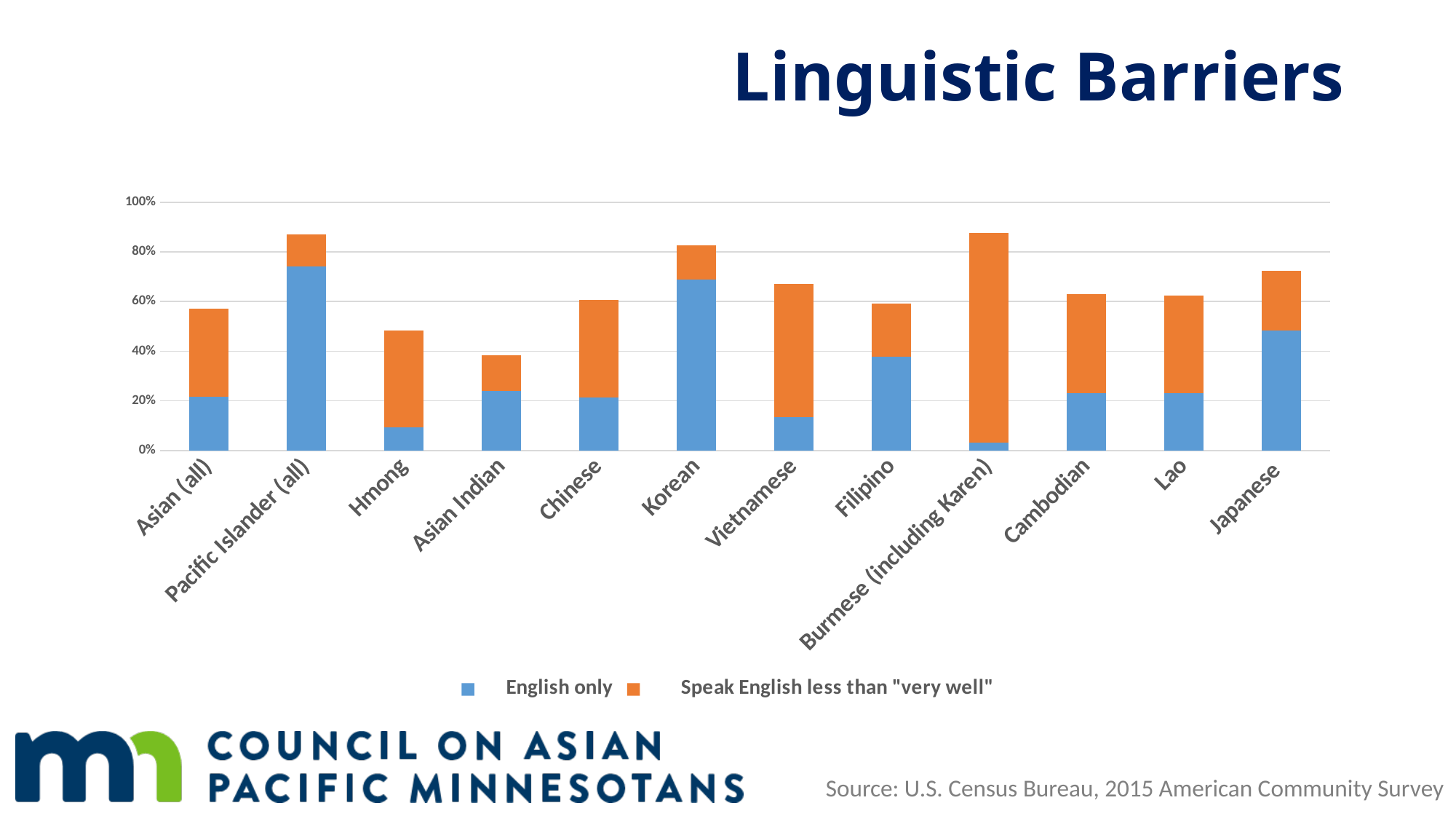
Is the 'English only' value for Japanese greater or less than 40%? greater Is the 'English only' value for Hmong greater or less than 20%? less How many series does the legend list? 2 How many population groups are shown along the x axis? 12 Which group has the largest 'Speak English less than "very well"' segment? Burmese (including Karen) Which group has the lowest 'English only' value? Burmese (including Karen) Which group has the highest 'English only' value? Pacific Islander (all) Is the 'English only' value for Pacific Islander (all) greater or less than 60%? greater Which has the larger 'English only' value, Korean or Filipino? Korean Which has the larger 'Speak English less than "very well"' segment, Vietnamese or Korean? Vietnamese What kind of chart is shown on the slide? Stacked bar chart What colour represents the 'English only' series in the legend? Blue